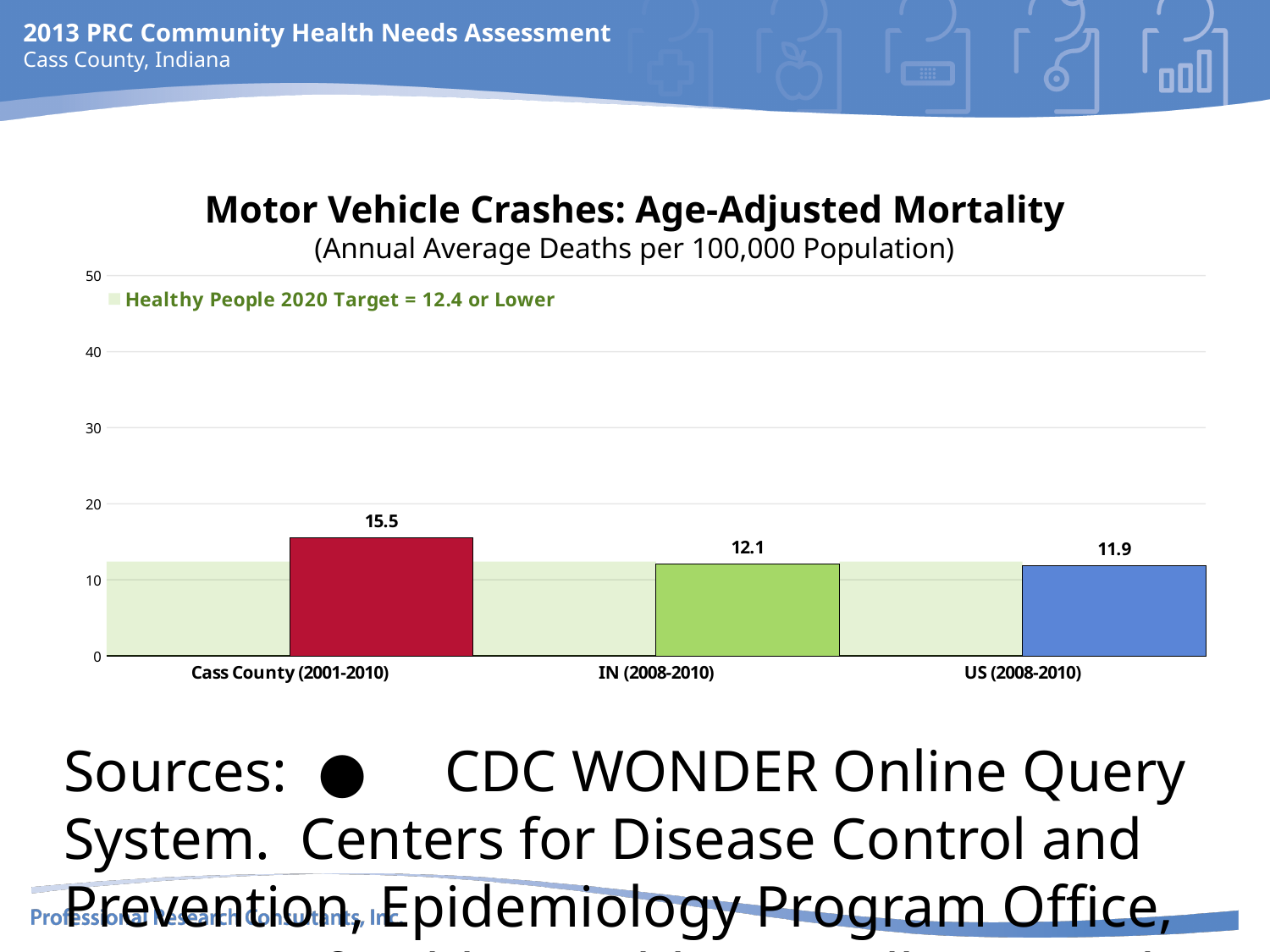
What is the value shown for US (2008-2010)? 11.9 What is the difference between the Cass County (2001-2010) value and the US (2008-2010) value? 3.6 Is the value for Cass County (2001-2010) greater or less than 20? less What kind of chart is shown on the slide? Bar chart How many categories are shown on the x axis? 3 What is the age-adjusted motor vehicle crash mortality rate for Cass County (2001-2010)? 15.5 Which is larger, the value for Cass County (2001-2010) or the value for IN (2008-2010)? Cass County (2001-2010) What is the difference between the Cass County (2001-2010) value and the IN (2008-2010) value? 3.4 What is the Healthy People 2020 Target shown in the legend? 12.4 or Lower What is the value shown for IN (2008-2010)? 12.1 Which category has the lowest mortality rate? US (2008-2010) Which category has the highest mortality rate? Cass County (2001-2010)